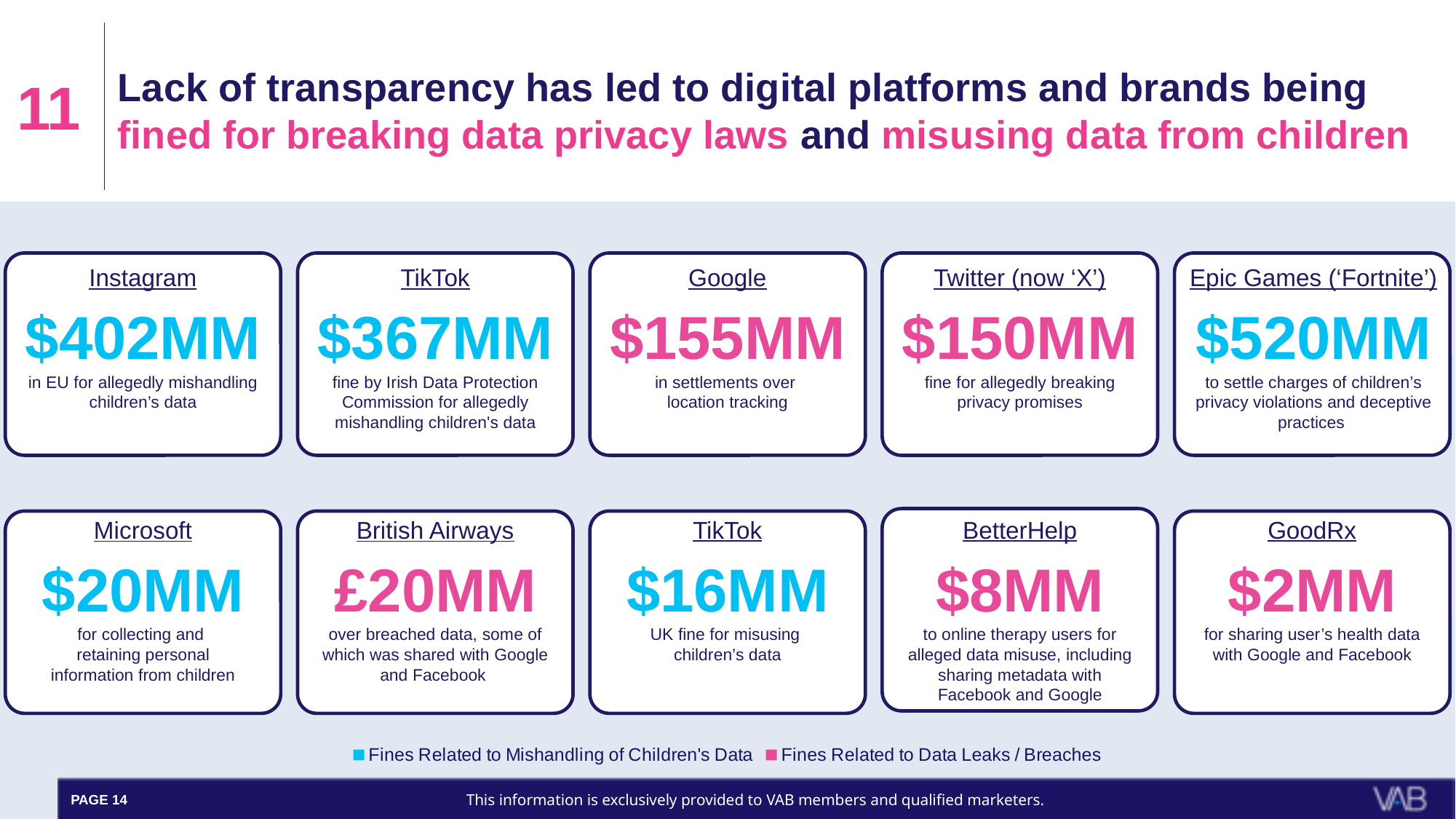
What is the amount shown for Epic Games ('Fortnite')? $520MM What is the difference between the Instagram fine and the TikTok fine by the Irish Data Protection Commission? $35MM How many company fine cards are shown on the slide? 10 According to the legend, what do the pink values represent? Fines Related to Data Leaks / Breaches Which is larger, the Google settlement amount or the Twitter (now 'X') fine? Google What is the amount shown for British Airways? £20MM Which company has the largest fine amount shown on the slide? Epic Games ('Fortnite') Which company has the smallest fine amount shown on the slide? GoodRx How many categories of fines does the legend list? 2 What is the amount shown for Google in settlements over location tracking? $155MM What is the UK fine amount shown for TikTok for misusing children's data? $16MM What is the fine amount shown for Instagram? $402MM